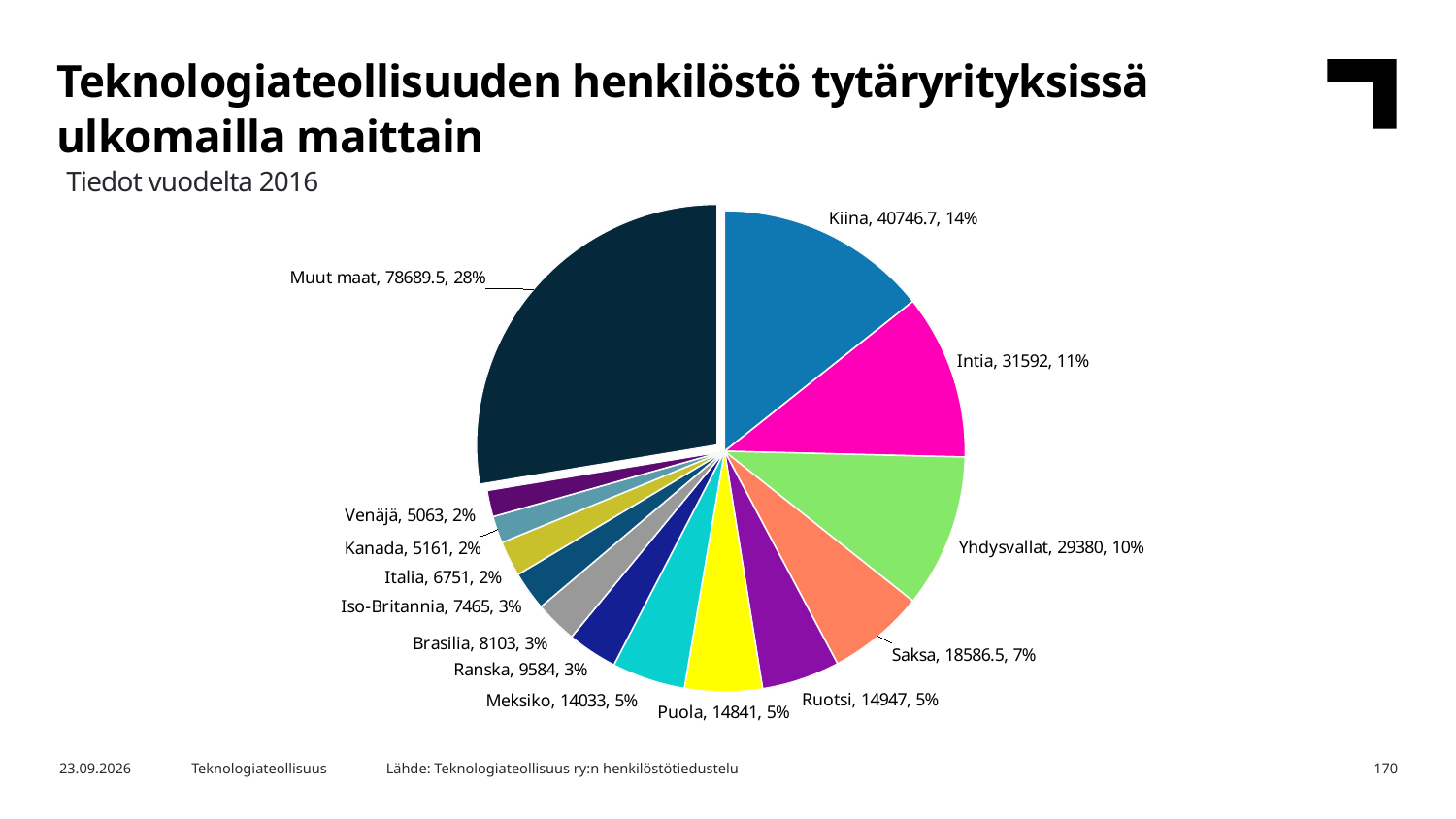
What is the value shown for Saksa? 18586.5 Which slice of the pie is the smallest? Venäjä How many slices does the pie chart have? 14 What kind of chart is shown on the slide? Pie chart Which slice of the pie is the largest? Muut maat Which is larger, the value for Ruotsi or the value for Puola? Ruotsi What is the value shown for Kiina? 40746.7 What is the difference between the values for Kiina and Intia? 9154.7 What share of the pie does Muut maat represent? 28% What is the value shown for Iso-Britannia? 7465 What year do the data on the slide come from, according to the subtitle? 2016 What percentage share is shown for Yhdysvallat? 10%